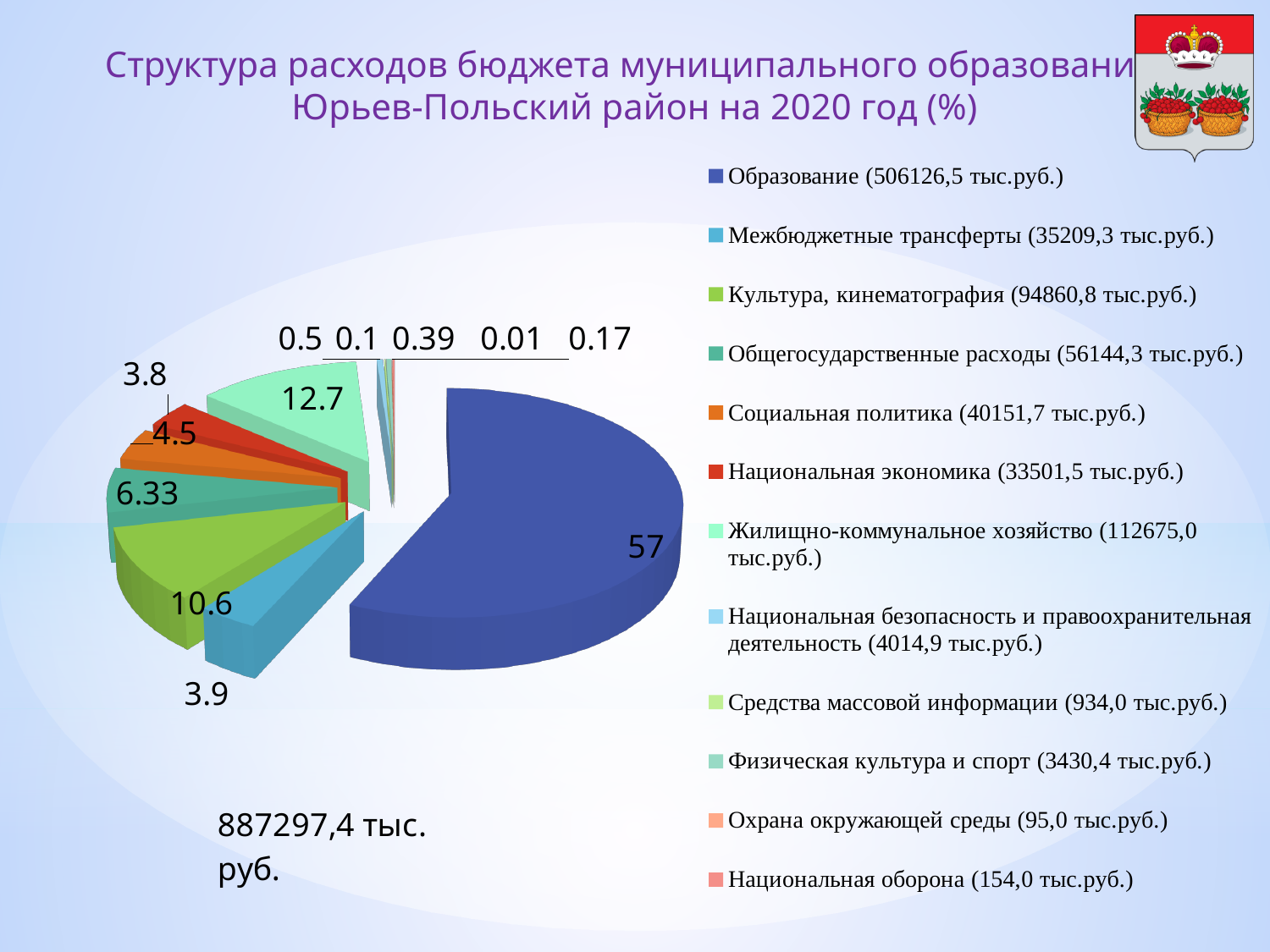
What is the difference in percentage points between the shares of Образование and Жилищно-коммунальное хозяйство? 44.3 What total amount in тыс. руб. is printed below the pie chart? 887297,4 тыс. руб. What type of chart is shown on the slide? pie chart Which has a larger share: Культура, кинематография or Общегосударственные расходы? Культура, кинематография What percentage share does Жилищно-коммунальное хозяйство have in the pie chart? 12.7 What percentage share does Образование have in the pie chart? 57 What percentage share does Социальная политика have in the pie chart? 4.5 What percentage share does Культура, кинематография have in the pie chart? 10.6 Which category has the smallest share of the pie chart? Охрана окружающей среды What percentage share does Общегосударственные расходы have in the pie chart? 6.33 Which category has the largest share of the pie chart? Образование How many categories does the legend of the pie chart list? 12